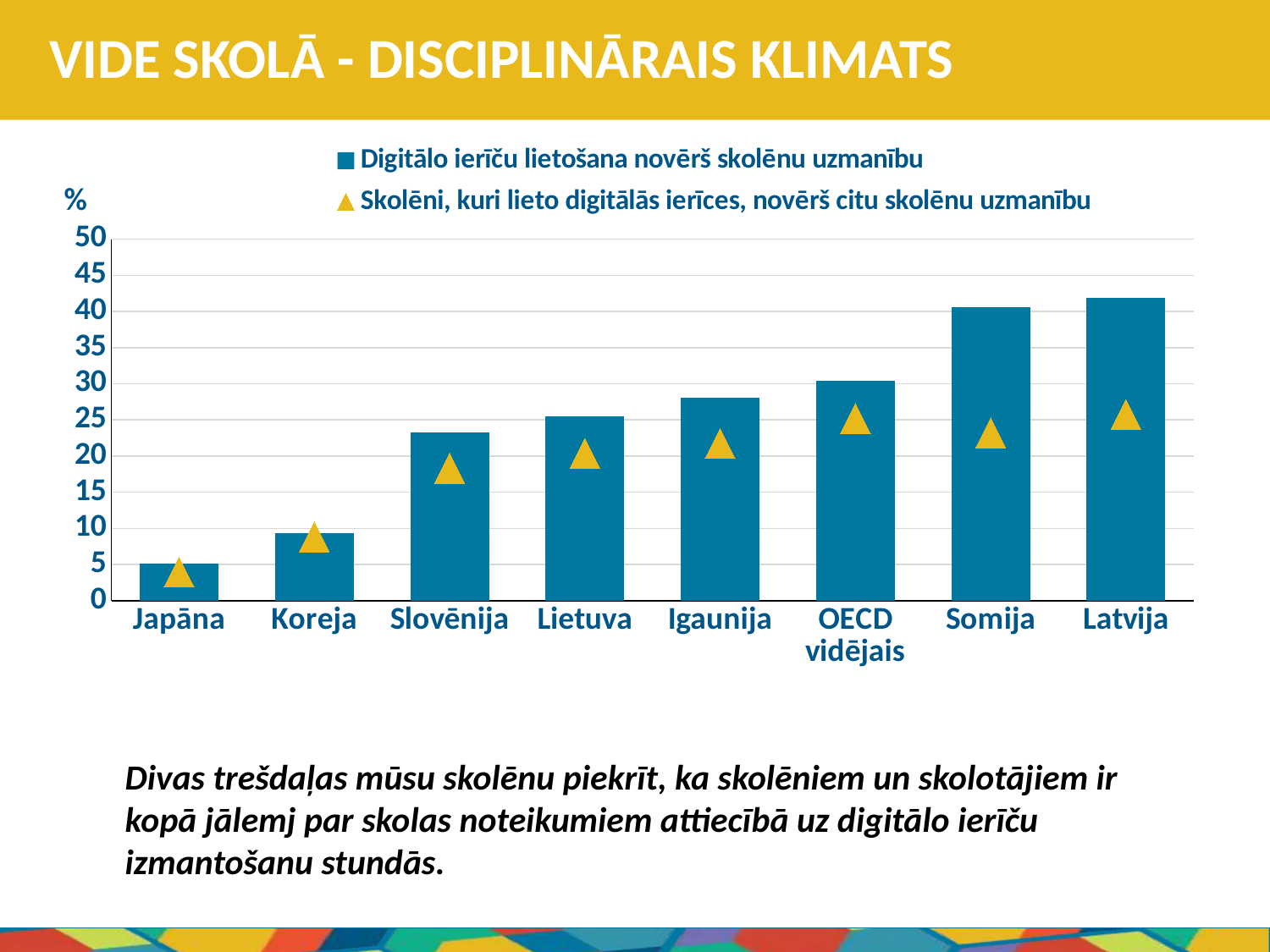
Which has a taller bar, Igaunija or Lietuva? Igaunija How many series does the chart legend list? 2 Which category has the lowest bar for 'Digitālo ierīču lietošana novērš skolēnu uzmanību'? Japāna How many categories are shown on the x axis of the chart? 8 What colour are the bars in the chart? blue What kind of chart is shown on the slide? bar chart Is the bar value for Somija greater or less than 35? greater Do the bar values rise or fall from left to right along the x axis? rise Is the triangle marker value for Slovēnija greater or less than 20? less Which category has the highest bar for 'Digitālo ierīču lietošana novērš skolēnu uzmanību'? Latvija